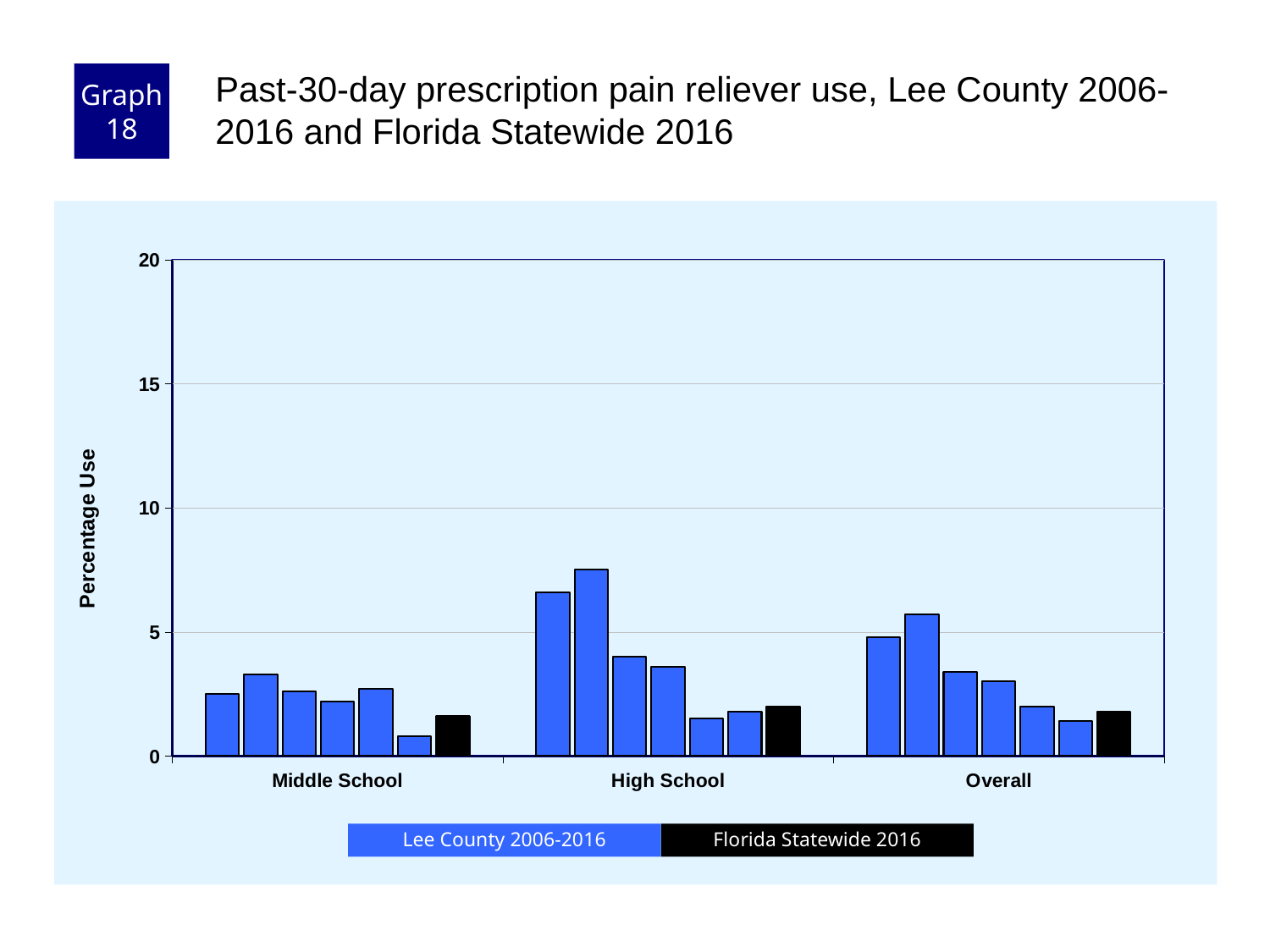
What is the label on the y axis? Percentage Use Which is larger: the tallest bar in the High School group or the tallest bar in the Overall group? High School How many school-level categories are shown on the x axis? 3 How many series does the legend list? 2 Is the tallest Lee County 2006-2016 bar for High School greater or less than 5? greater Is the Florida Statewide 2016 value for High School greater or less than 5? less Which colour represents Florida Statewide 2016 in the legend? black Which is larger: the Florida Statewide 2016 bar for Middle School or the tallest Lee County 2006-2016 bar for Middle School? the tallest Lee County 2006-2016 bar Which category group contains the tallest bar on the chart? High School Is the tallest Lee County 2006-2016 bar for Middle School greater or less than 5? less What kind of chart is shown on the slide? bar chart